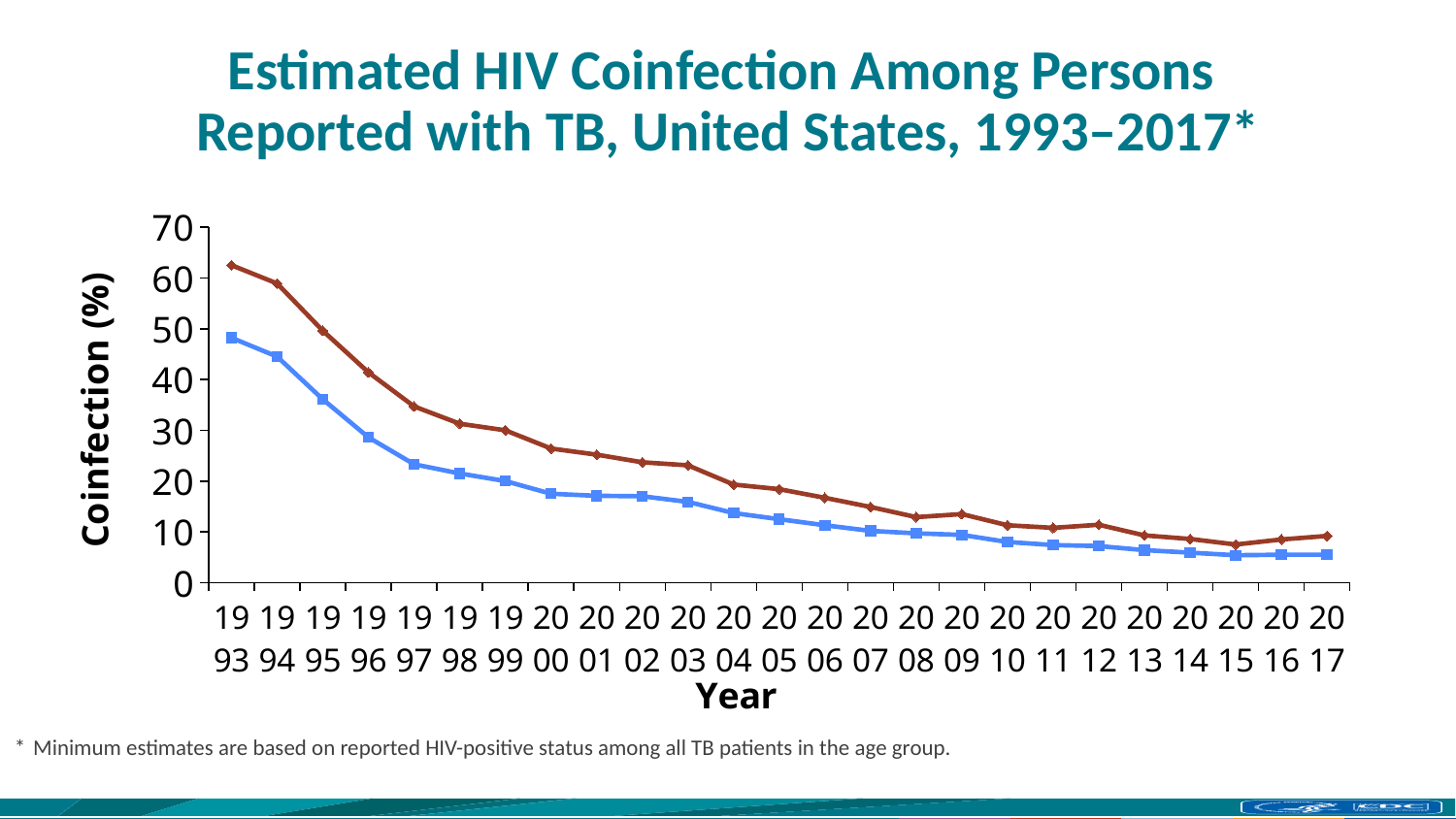
How many lines are plotted on the chart? 2 Is the value of the blue square line in 1993 greater or less than 40? greater What kind of chart is shown on the slide? line chart Is the value of the blue square line in 2000 greater or less than 20? less Is the value of the brown diamond line in 1993 greater or less than 60? greater In which year does the brown diamond line reach its highest value? 1993 Do the values of the lines rise or fall from 1993 to 2017? fall What is the title of the y axis? Coinfection (%) In 1993, which line has the higher value, the brown diamond line or the blue square line? brown diamond line How many years are plotted along the x axis? 25